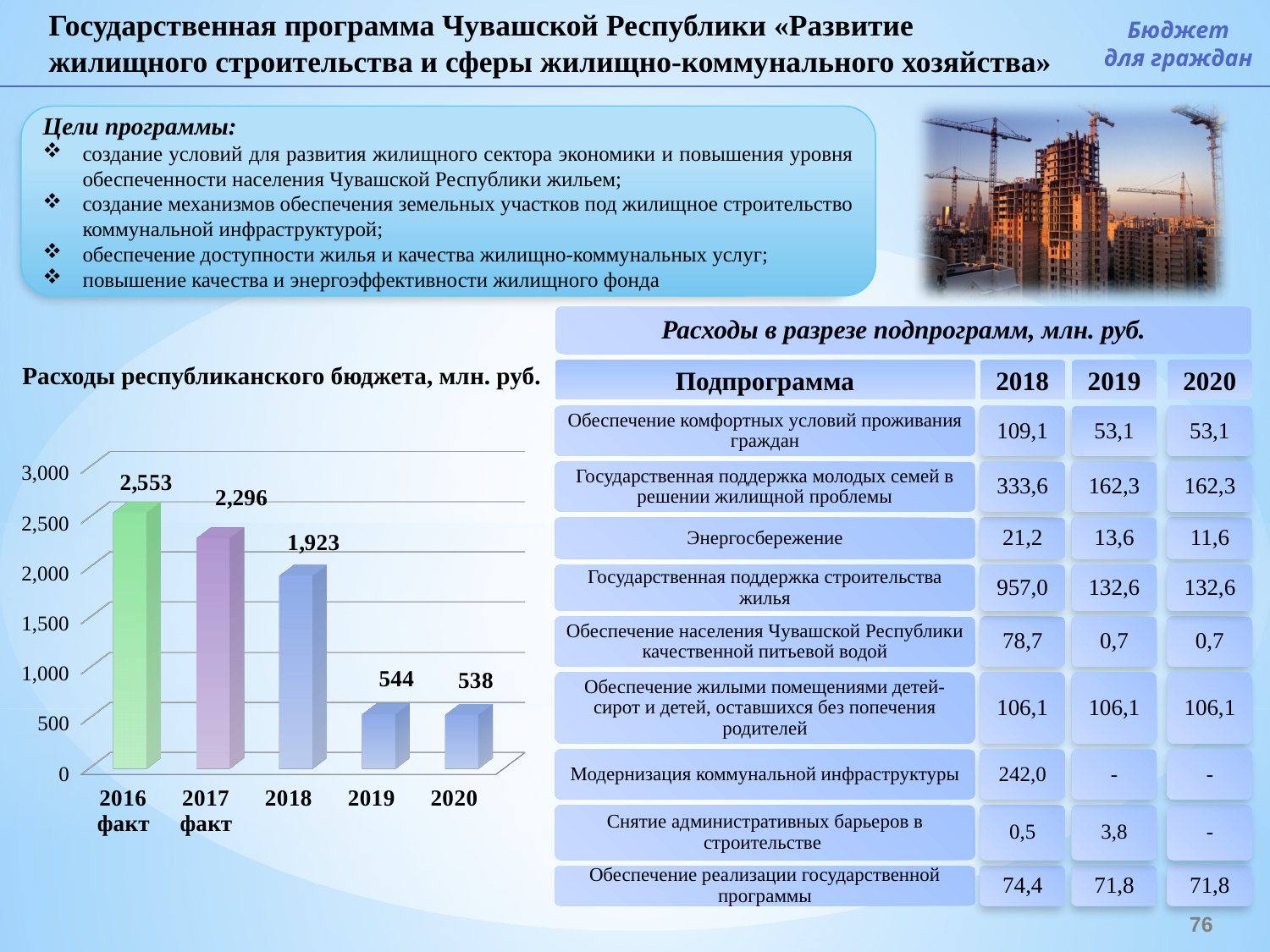
Which year has the lowest value in the chart 'Расходы республиканского бюджета, млн. руб.'? 2020 Do the values in the chart 'Расходы республиканского бюджета, млн. руб.' rise or fall from 2016 факт to 2020? fall In the chart 'Расходы республиканского бюджета, млн. руб.', which is larger: the value for 2016 факт or the value for 2017 факт? 2016 факт What kind of chart is 'Расходы республиканского бюджета, млн. руб.'? bar chart Is the value for 2019 in the chart 'Расходы республиканского бюджета, млн. руб.' greater or less than 1,000? less What is the difference between the values for 2017 факт and 2018 in the chart 'Расходы республиканского бюджета, млн. руб.'? 373 What is the value for 2020 in the chart 'Расходы республиканского бюджета, млн. руб.'? 538 What is the value for 2016 факт in the chart 'Расходы республиканского бюджета, млн. руб.'? 2,553 How many years are shown in the chart 'Расходы республиканского бюджета, млн. руб.'? 5 What is the value for 2018 in the chart 'Расходы республиканского бюджета, млн. руб.'? 1,923 What is the difference between the values for 2019 and 2020 in the chart 'Расходы республиканского бюджета, млн. руб.'? 6 Which year has the highest value in the chart 'Расходы республиканского бюджета, млн. руб.'? 2016 факт